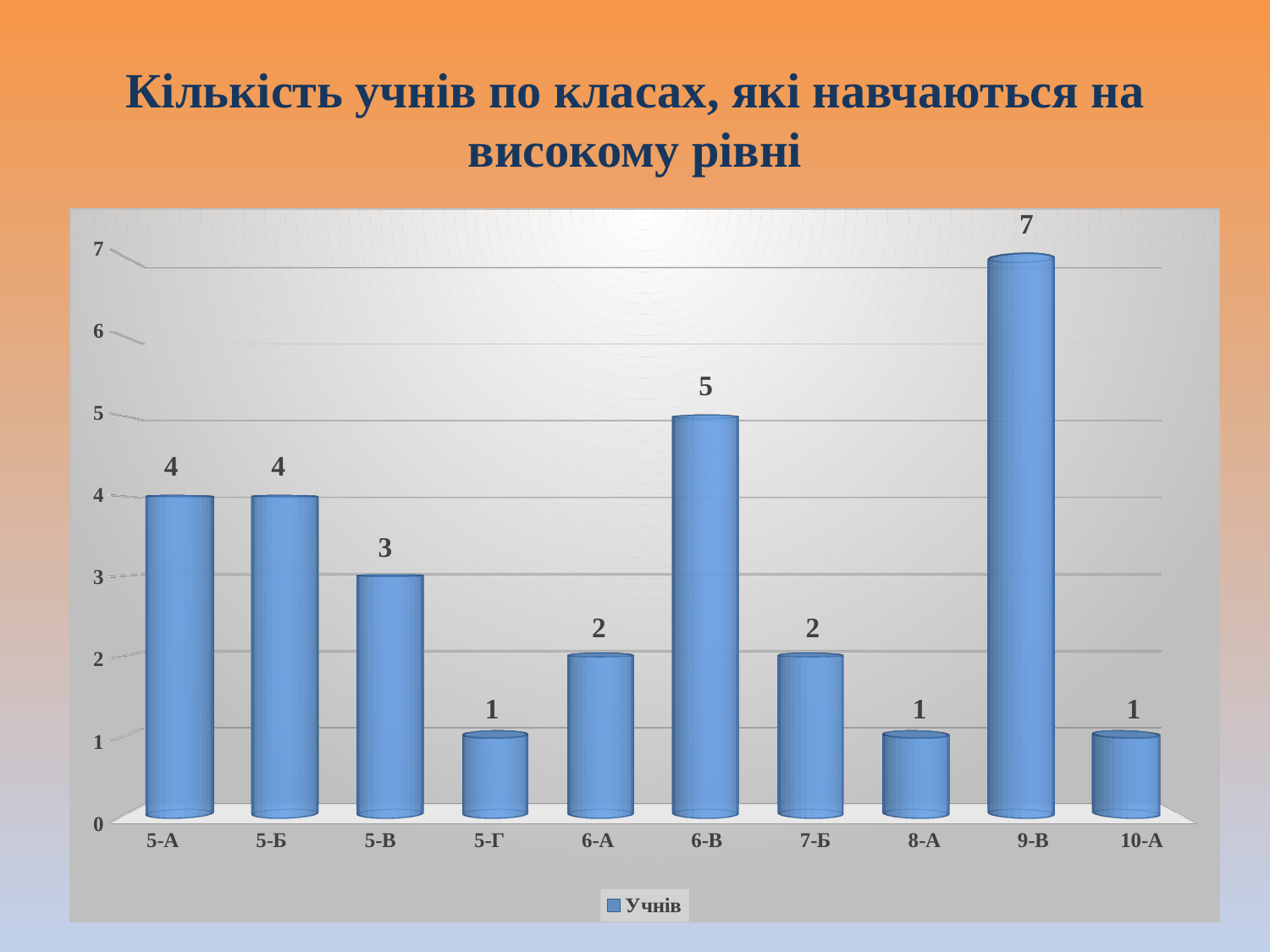
What is the difference between the values for 5-Б and 5-Г? 3 What is the title of the chart? Кількість учнів по класах, які навчаються на високому рівні How many classes are shown on the x axis? 10 What is the value for 5-В? 3 What is the difference between the values for 9-В and 6-В? 2 What is the value for 9-В? 7 How many series does the legend list? 1 What is the legend entry for the series? Учнів What is the value for 6-В? 5 Which class has the highest value? 9-В What kind of chart is this? bar chart Which is larger, the value for 5-А or the value for 6-А? 5-А